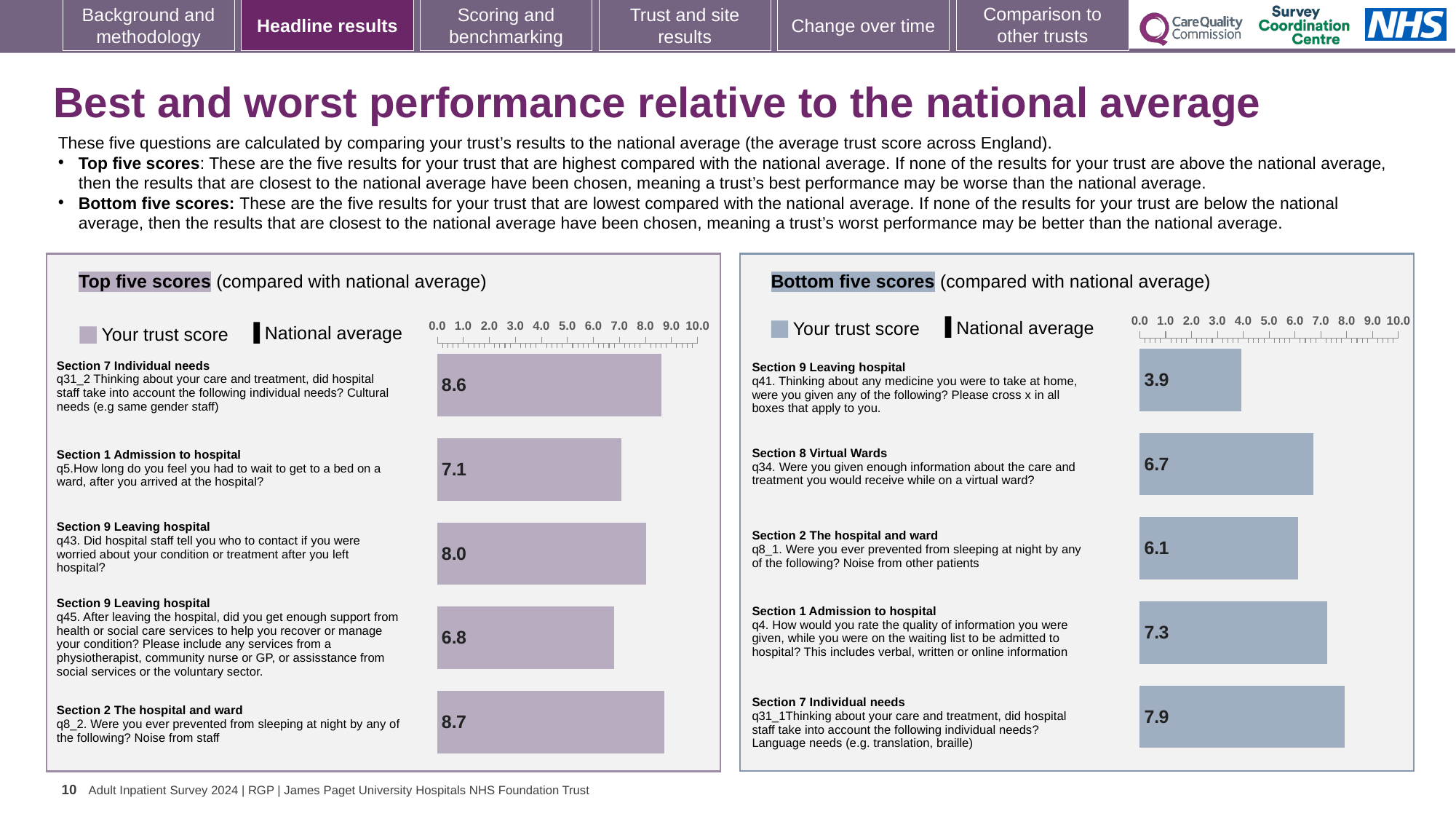
In the Bottom five scores chart, which question has the lowest trust score? q41 (medicine to take at home) What type of chart is used in the Top five scores panel? Bar chart In the Bottom five scores chart, what is the trust score for q4 (quality of information while on the waiting list)? 7.3 In the Top five scores chart, what is the trust score for q43 (did hospital staff tell you who to contact if you were worried after leaving hospital)? 8.0 In the Top five scores chart, which question has the lowest trust score? q45 (support from health or social care services after leaving hospital) In the Top five scores chart, what is the trust score for q5 (how long you had to wait to get to a bed on a ward)? 7.1 In the Bottom five scores chart, which question has the highest trust score? q31_1 (Language needs) In the Bottom five scores chart, what is the trust score for q41 (medicine to take at home)? 3.9 In the Top five scores chart, what is the difference between the scores for q8_2 and q45? 1.9 In the Bottom five scores chart, is the score for q34 (virtual ward information) larger or smaller than the score for q8_1 (noise from other patients)? larger How many questions are plotted in the Bottom five scores chart? 5 In the Top five scores chart, which question has the highest trust score? q8_2 (Noise from staff)